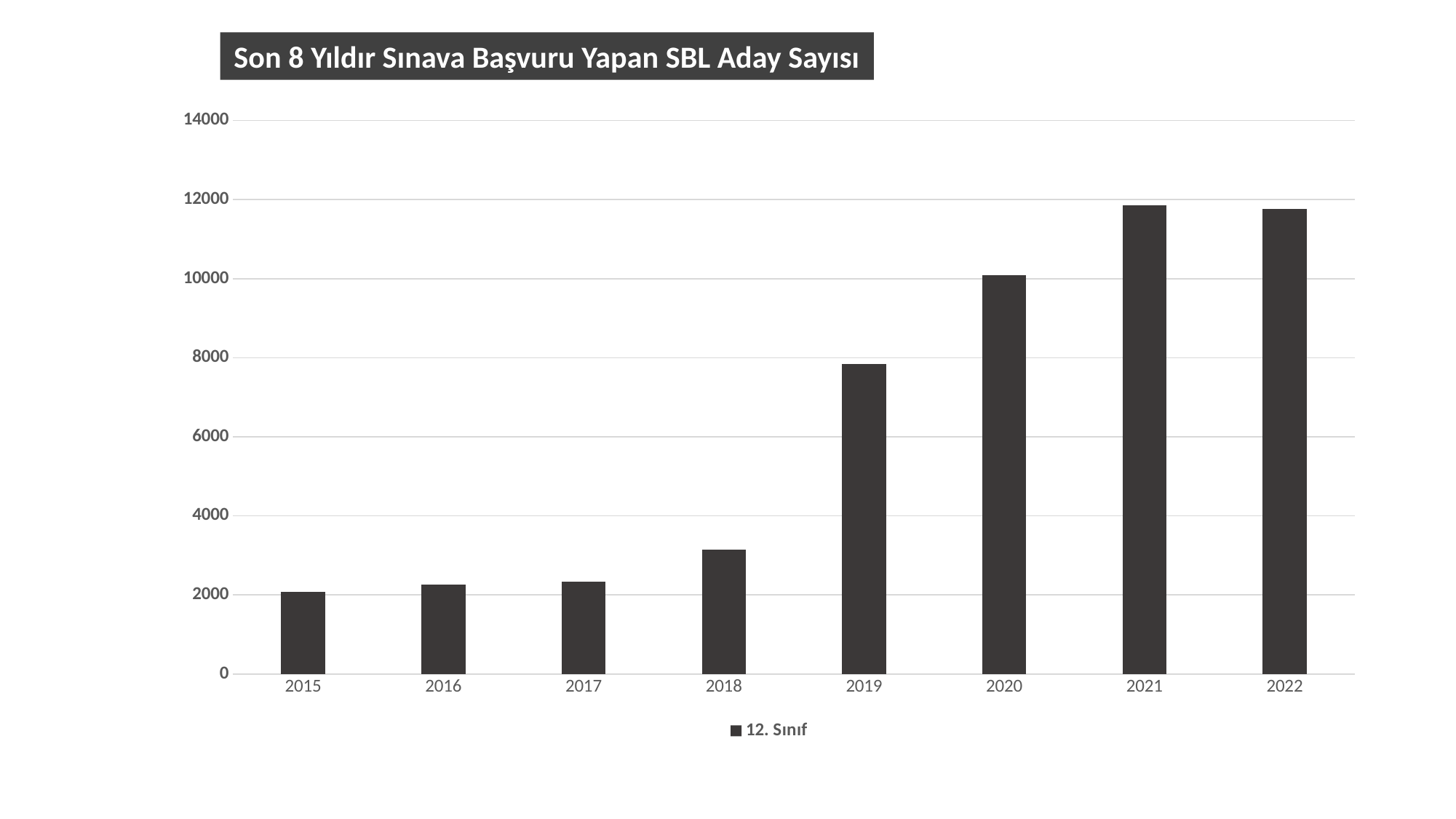
Is the value for 2018 greater or less than 4000? less Is the value for 2021 greater or less than 10000? greater Which year has the lowest number of applicants? 2015 Is the value for 2022 greater or less than 12000? less How many years are shown on the x axis of the chart? 8 What is the title of the chart? Son 8 Yıldır Sınava Başvuru Yapan SBL Aday Sayısı What is the legend entry of the chart? 12. Sınıf How many series does the legend list? 1 What kind of chart is shown on the slide? bar chart Which year has the larger value, 2019 or 2020? 2020 Do the values generally rise or fall from 2015 to 2022? rise